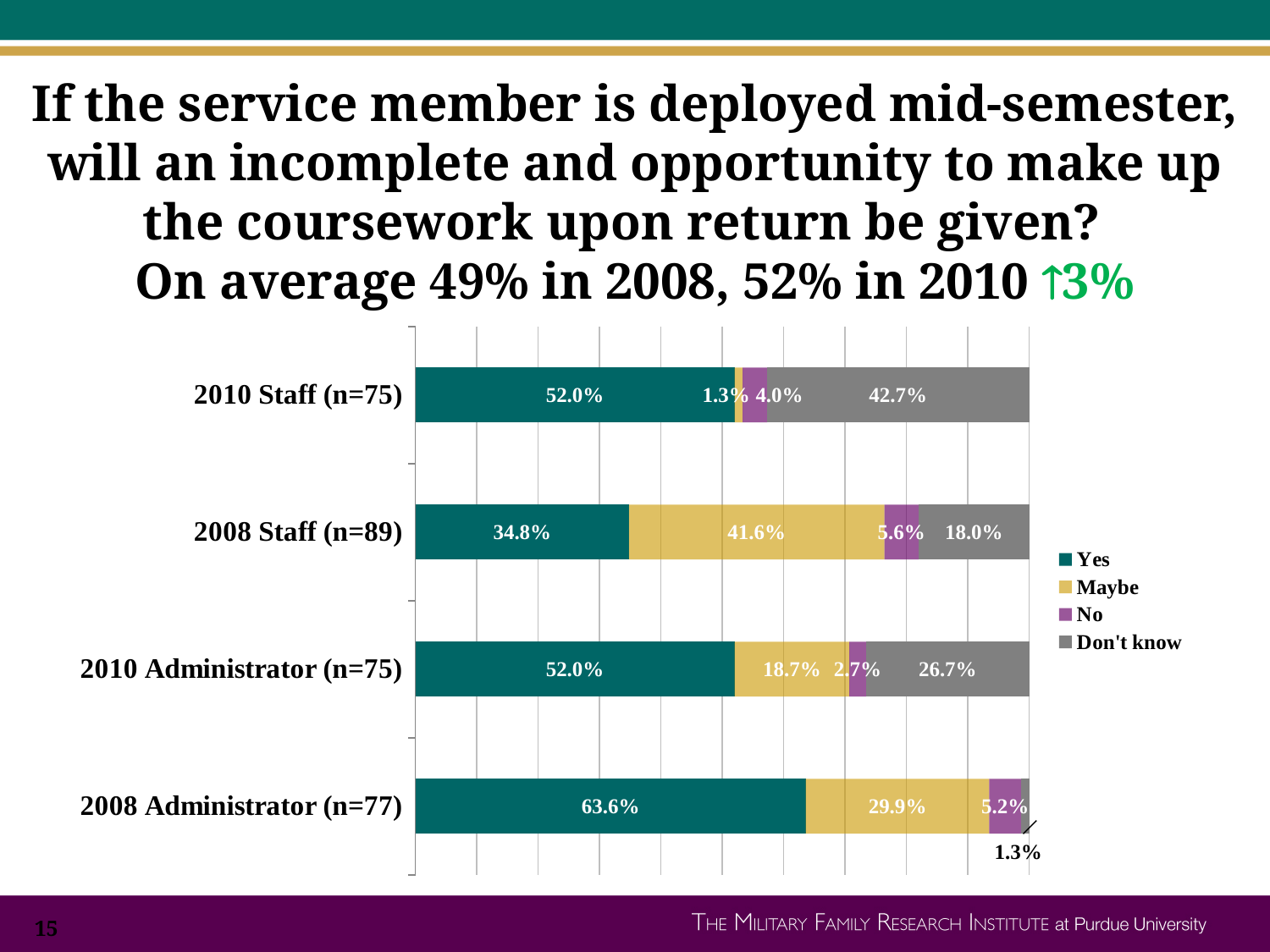
What is the difference between the "Yes" values for 2008 Administrator (n=77) and 2010 Administrator (n=75)? 11.6% Which legend entry is shown in grey? Don't know What kind of chart is shown on the slide? Stacked bar chart What is the "No" value for 2010 Administrator (n=75)? 2.7% What is the "Maybe" value for 2008 Staff (n=89)? 41.6% Which category has the lowest "Yes" value? 2008 Staff (n=89) Which is larger: the "Don't know" value for 2010 Staff (n=75) or for 2008 Staff (n=89)? 2010 Staff (n=75) What is the "Yes" value for 2008 Administrator (n=77)? 63.6% How many series does the legend list? 4 How many categories (bars) are shown in the chart? 4 What is the "Don't know" value for 2010 Staff (n=75)? 42.7% Which category has the highest "Yes" value? 2008 Administrator (n=77)